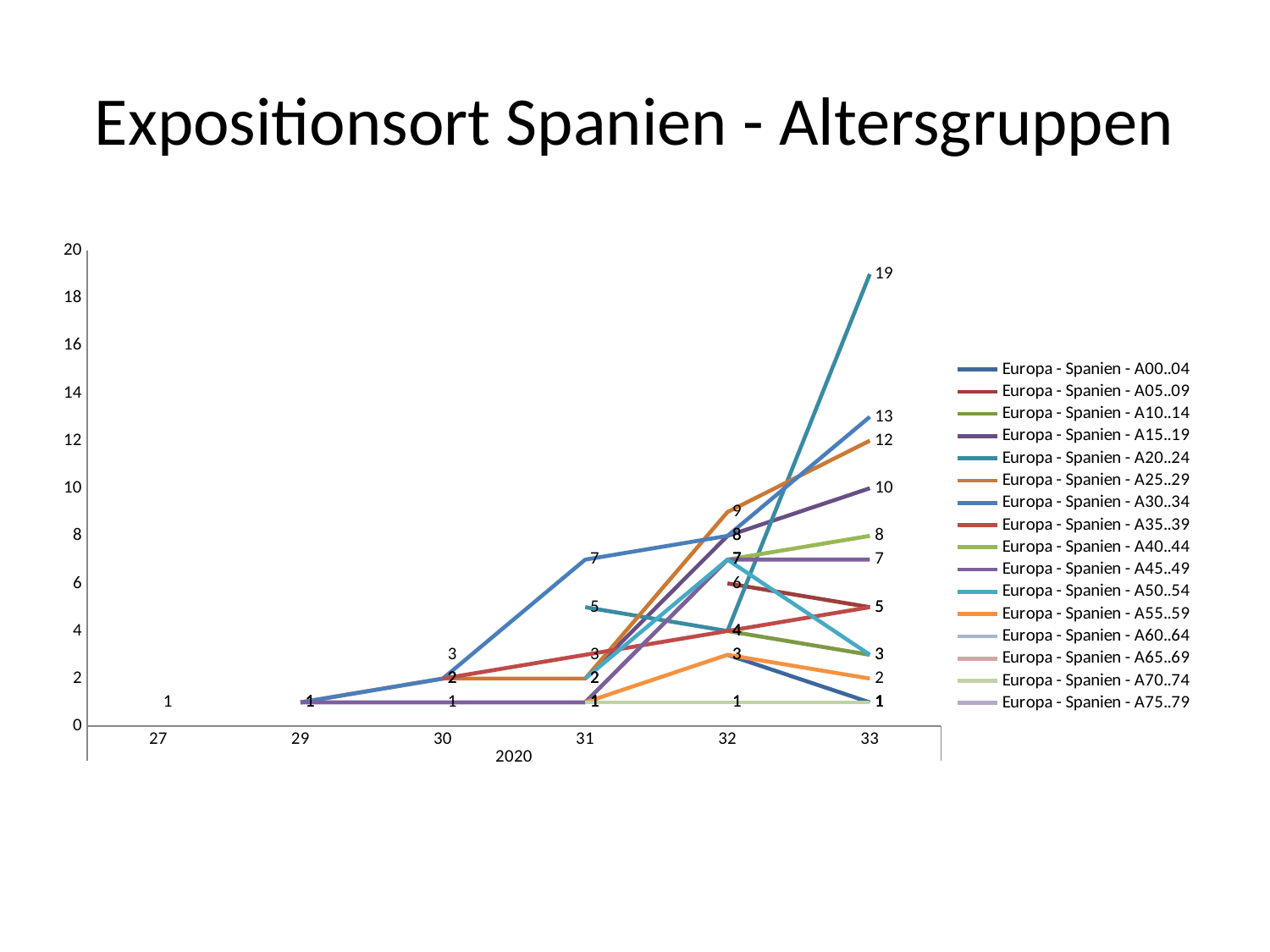
What is the difference between the highest value at week 33 (19) and the value for Europa - Spanien - A30..34 at week 33? 6 What is the value for Europa - Spanien - A30..34 at week 33? 13 What is the highest value plotted anywhere on the chart? 19 What is the title of the chart? Expositionsort Spanien - Altersgruppen Does the value for Europa - Spanien - A30..34 rise or fall from week 29 to week 33? rise What kind of chart is shown on the slide? line chart How many series does the legend list? 16 What is the value for Europa - Spanien - A25..29 at week 33? 12 How many categories are shown on the x axis? 6 What is the highest value plotted at week 33? 19 What is the value for Europa - Spanien - A30..34 at week 31? 7 Is the highest value at week 33 greater or less than 18? greater